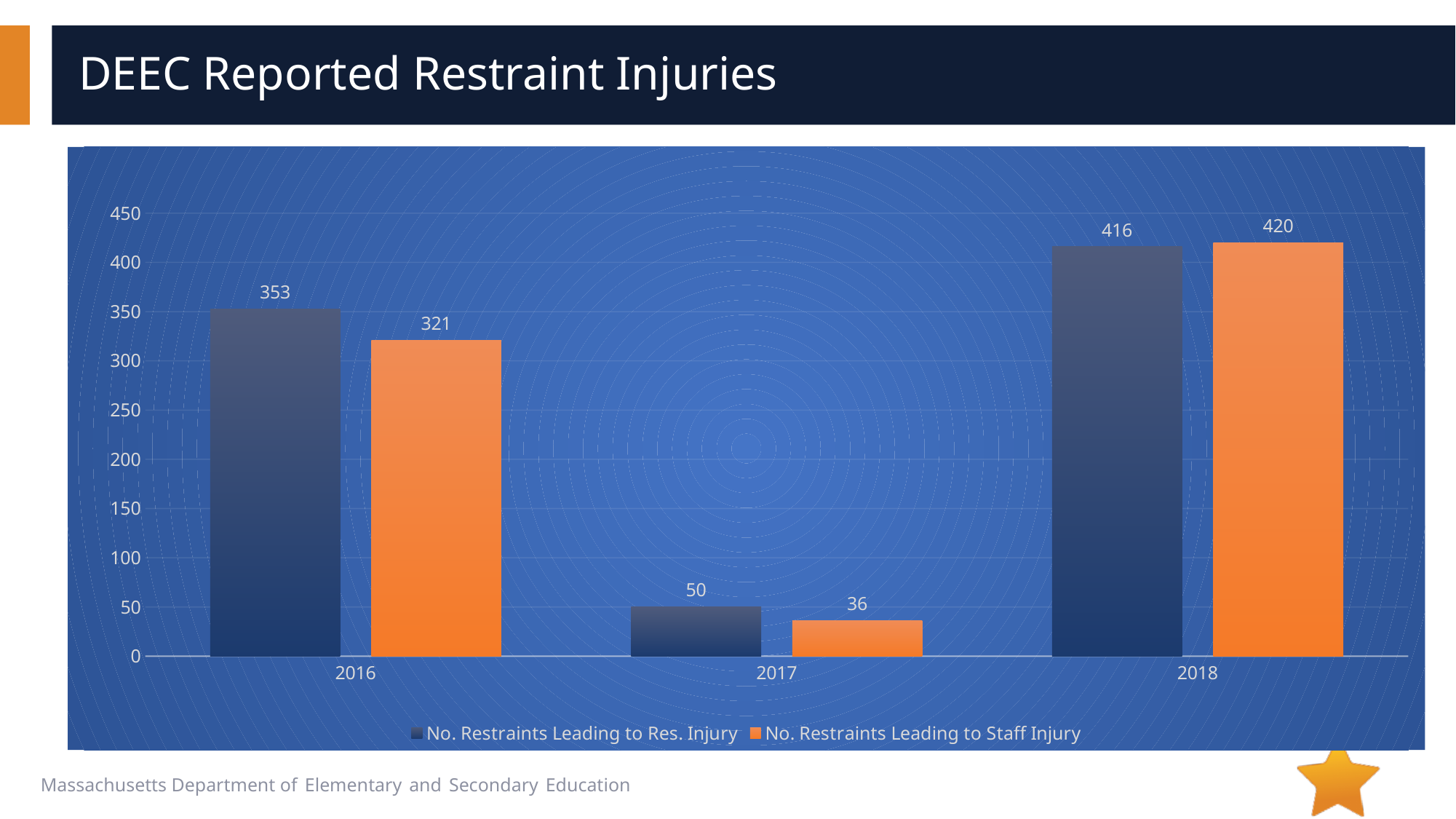
What is the difference between restraints leading to resident injury and restraints leading to staff injury in 2016? 32 Which year has the lowest number of restraints leading to staff injury? 2017 Is the number of restraints leading to staff injury in 2016 greater or less than 300? greater What is the number of restraints leading to resident injury in 2016? 353 What kind of chart is shown on the slide? Bar chart In 2017, which is larger: restraints leading to resident injury or restraints leading to staff injury? Restraints leading to resident injury How many years are shown on the x axis? 3 How many series does the legend list? 2 What is the title of the slide containing the chart? DEEC Reported Restraint Injuries What is the number of restraints leading to staff injury in 2018? 420 What is the number of restraints leading to staff injury in 2017? 36 Which year has the highest number of restraints leading to resident injury? 2018